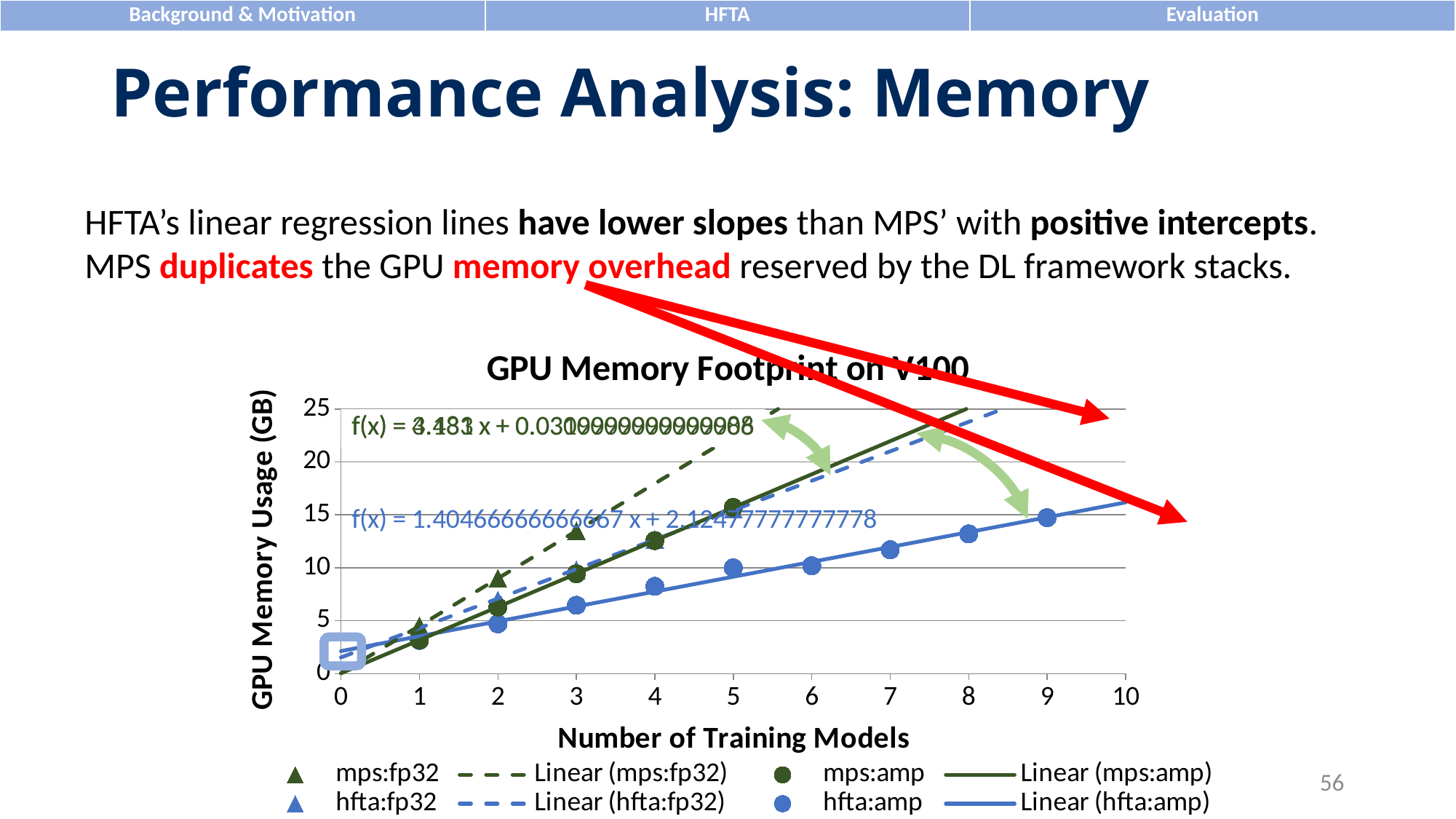
How many data points are plotted for the mps:amp series? 5 What is the intercept shown in the regression equation for the hfta line (blue equation)? 2.12477777777778 How many entries does the chart legend list? 8 Is the mps:amp value at 4 training models greater or less than 10? greater What is the label of the x axis? Number of Training Models What is the title of the chart? GPU Memory Footprint on V100 Does GPU memory usage rise or fall as the number of training models increases? rise Is the mps:fp32 value at 3 training models greater or less than 10? greater How many data points are plotted for the hfta:amp series? 9 Is the hfta:amp value at 8 training models greater or less than 15? less At 4 training models, which series uses more GPU memory, mps:amp or hfta:amp? mps:amp What kind of chart is shown on the slide? scatter chart with linear trendlines